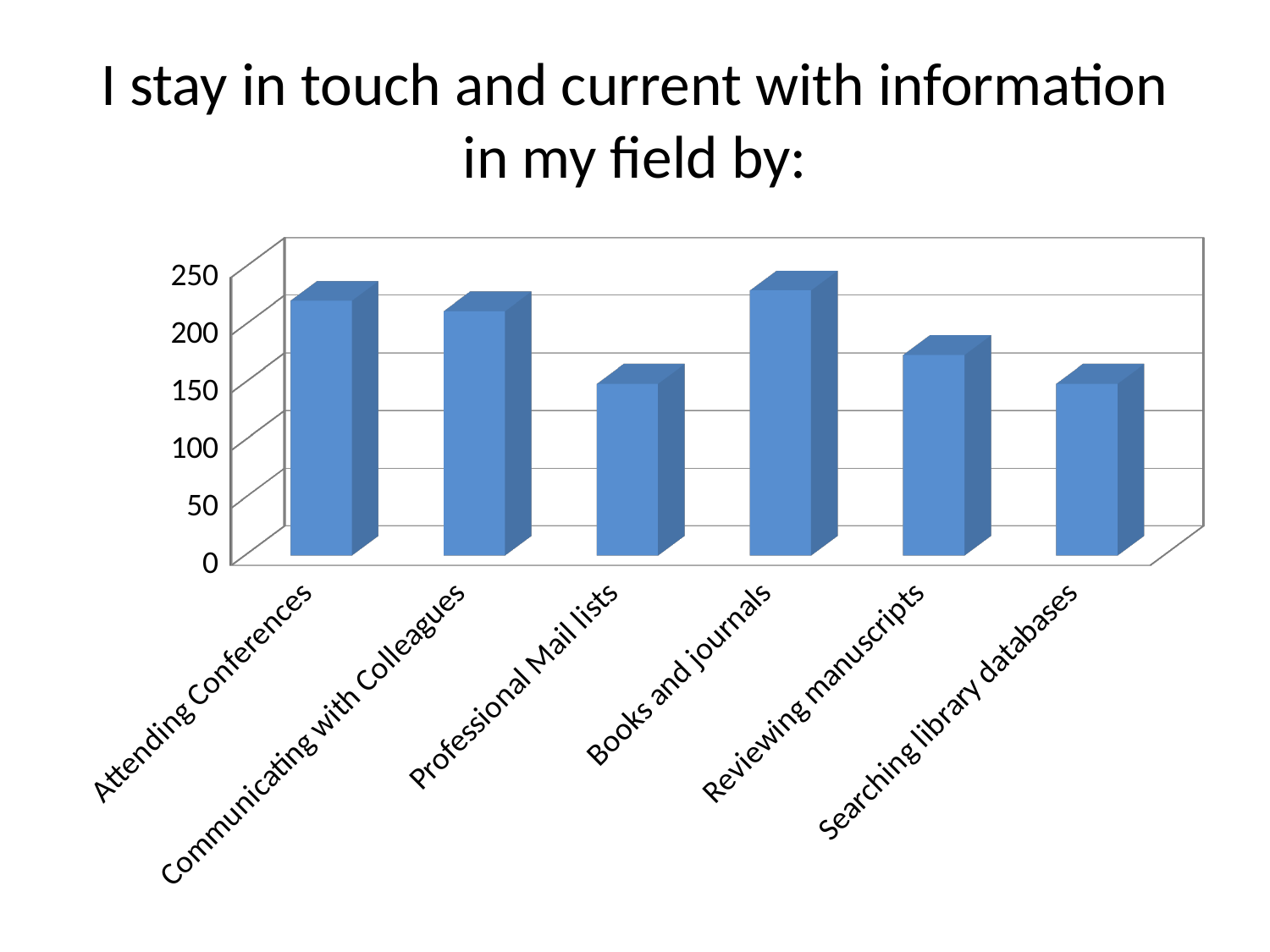
Is the value for Professional Mail lists greater or less than 200? less Is the value for Books and journals greater or less than 200? greater What is the title of the slide containing the chart? I stay in touch and current with information in my field by: Is the value for Attending Conferences greater or less than 200? greater What kind of chart is shown on the slide? bar chart Which is larger, the value for Attending Conferences or the value for Professional Mail lists? Attending Conferences Which is larger, the value for Books and journals or the value for Reviewing manuscripts? Books and journals How many categories are shown on the x axis of the chart? 6 Which category has the highest bar in the chart? Books and journals Which is larger, the value for Communicating with Colleagues or the value for Searching library databases? Communicating with Colleagues